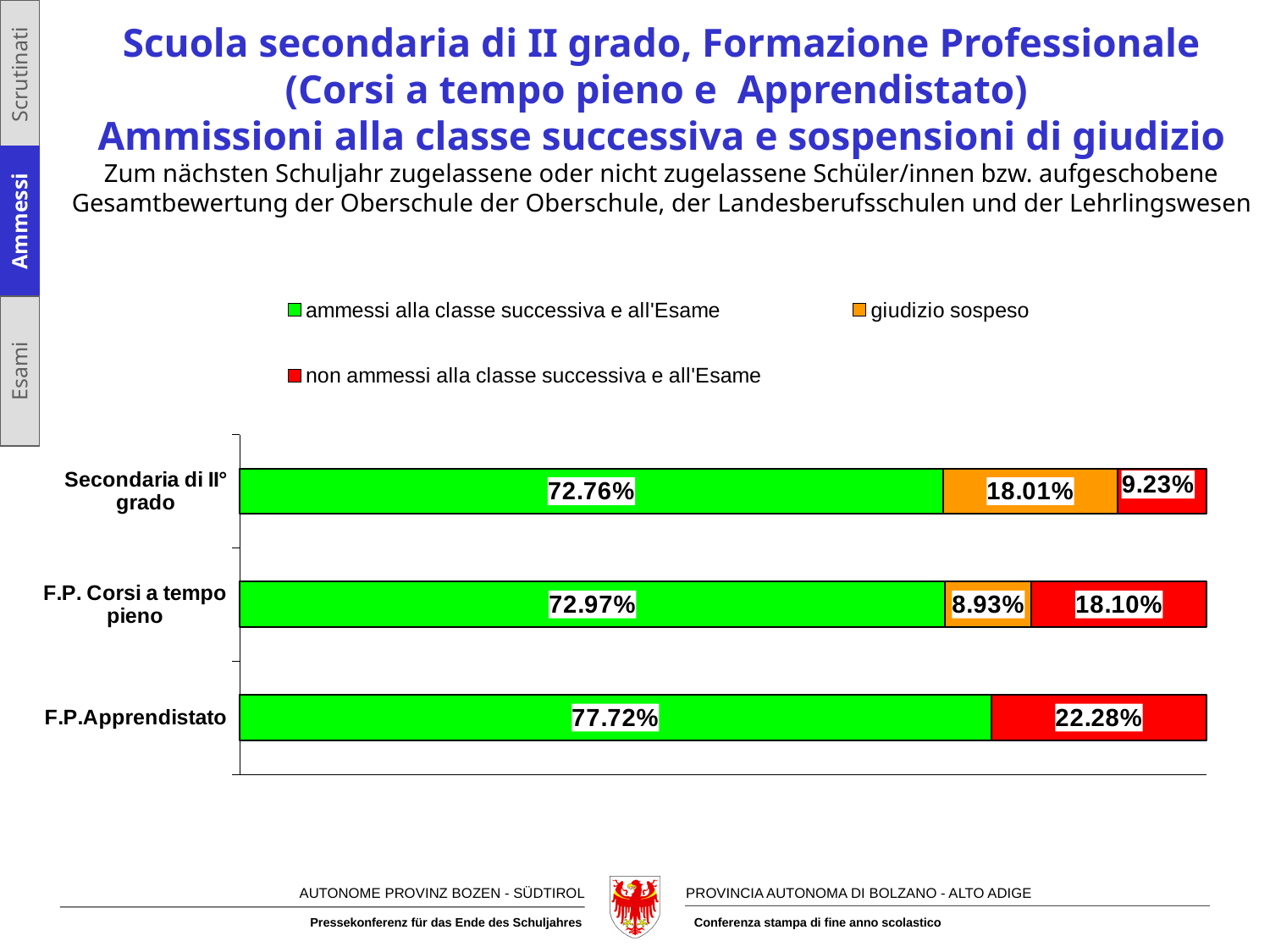
What percentage of students in 'Secondaria di II° grado' were 'ammessi alla classe successiva e all'Esame'? 72.76% What is the difference in percentage points between the 'non ammessi' value for 'F.P. Corsi a tempo pieno' and its 'giudizio sospeso' value? 9.17 Which category has the highest share of 'ammessi alla classe successiva e all'Esame'? F.P.Apprendistato What is the 'non ammessi alla classe successiva e all'Esame' value for 'F.P.Apprendistato'? 22.28% What is the total of the stacked bar for 'F.P.Apprendistato'? 100.00% How many series does the legend list? 3 What kind of chart is shown on the slide? Stacked bar chart Which category has the lowest share of 'non ammessi alla classe successiva e all'Esame'? Secondaria di II° grado How many categories are shown on the chart? 3 Which is larger: the 'non ammessi' value for 'Secondaria di II° grado' or for 'F.P. Corsi a tempo pieno'? F.P. Corsi a tempo pieno What is the 'giudizio sospeso' value for 'F.P. Corsi a tempo pieno'? 8.93% Which colour represents 'giudizio sospeso' in the legend? Orange